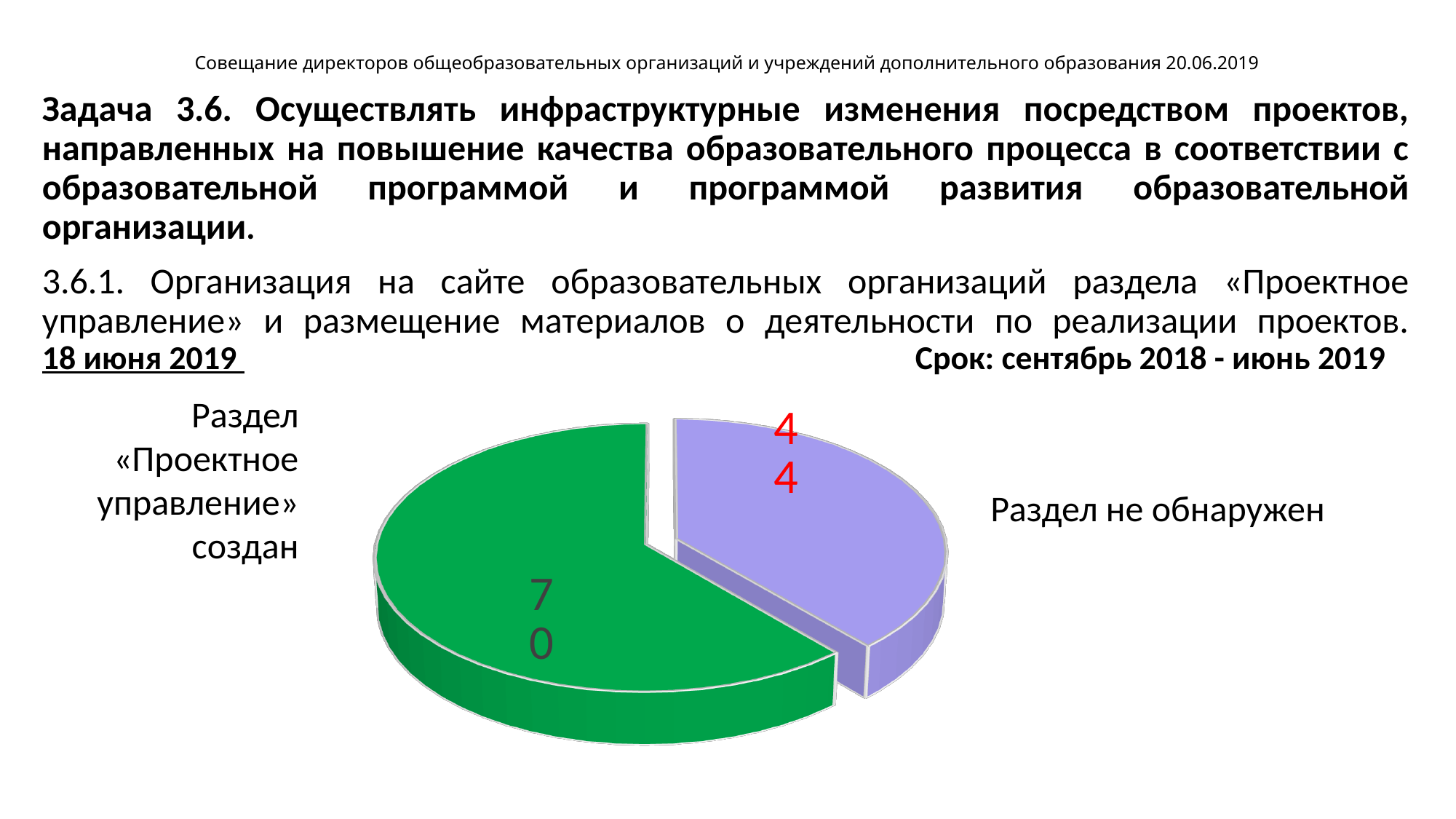
How many slices does the pie chart have? 2 Which category has the largest slice of the pie? Раздел «Проектное управление» создан What value is shown for the slice labelled «Раздел «Проектное управление» создан»? 70 What share of the pie does the slice «Раздел «Проектное управление» создан» represent? 61.4% What is the total of the two values shown in the pie chart? 114 What kind of chart is shown on the slide? Pie chart What colour is the slice for «Раздел «Проектное управление» создан»? Green What colour is the slice for «Раздел не обнаружен»? Purple Which category has the smallest slice of the pie? Раздел не обнаружен Which is larger: the value for «Раздел «Проектное управление» создан» or the value for «Раздел не обнаружен»? Раздел «Проектное управление» создан What is the difference between the value for «Раздел «Проектное управление» создан» and the value for «Раздел не обнаружен»? 26 What value is shown for the slice labelled «Раздел не обнаружен»? 44